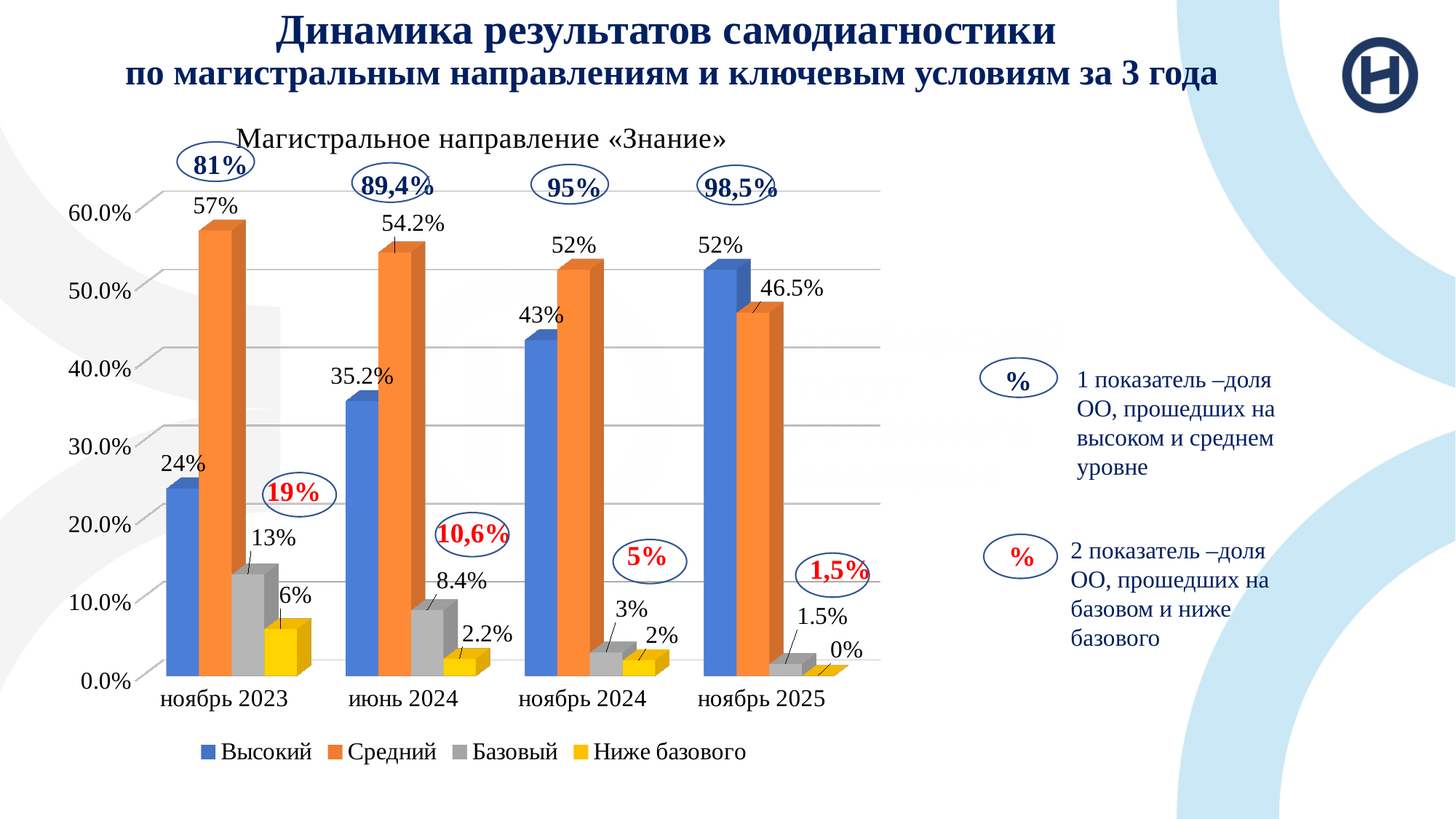
What is the value for Высокий in ноябрь 2023? 24% Which is larger in ноябрь 2025: Высокий or Средний? Высокий How many periods are shown on the x axis? 4 What is the value for Средний in июнь 2024? 54.2% What is the value for Базовый in ноябрь 2024? 3% How many series does the legend list? 4 What is the difference between Средний and Высокий in ноябрь 2023? 33% In which period is the Средний series lowest? ноябрь 2025 In which period is the Высокий series highest? ноябрь 2025 What is the value for Ниже базового in ноябрь 2025? 0% Does the Ниже базового series rise or fall from ноябрь 2023 to ноябрь 2025? fall What kind of chart is shown? bar chart